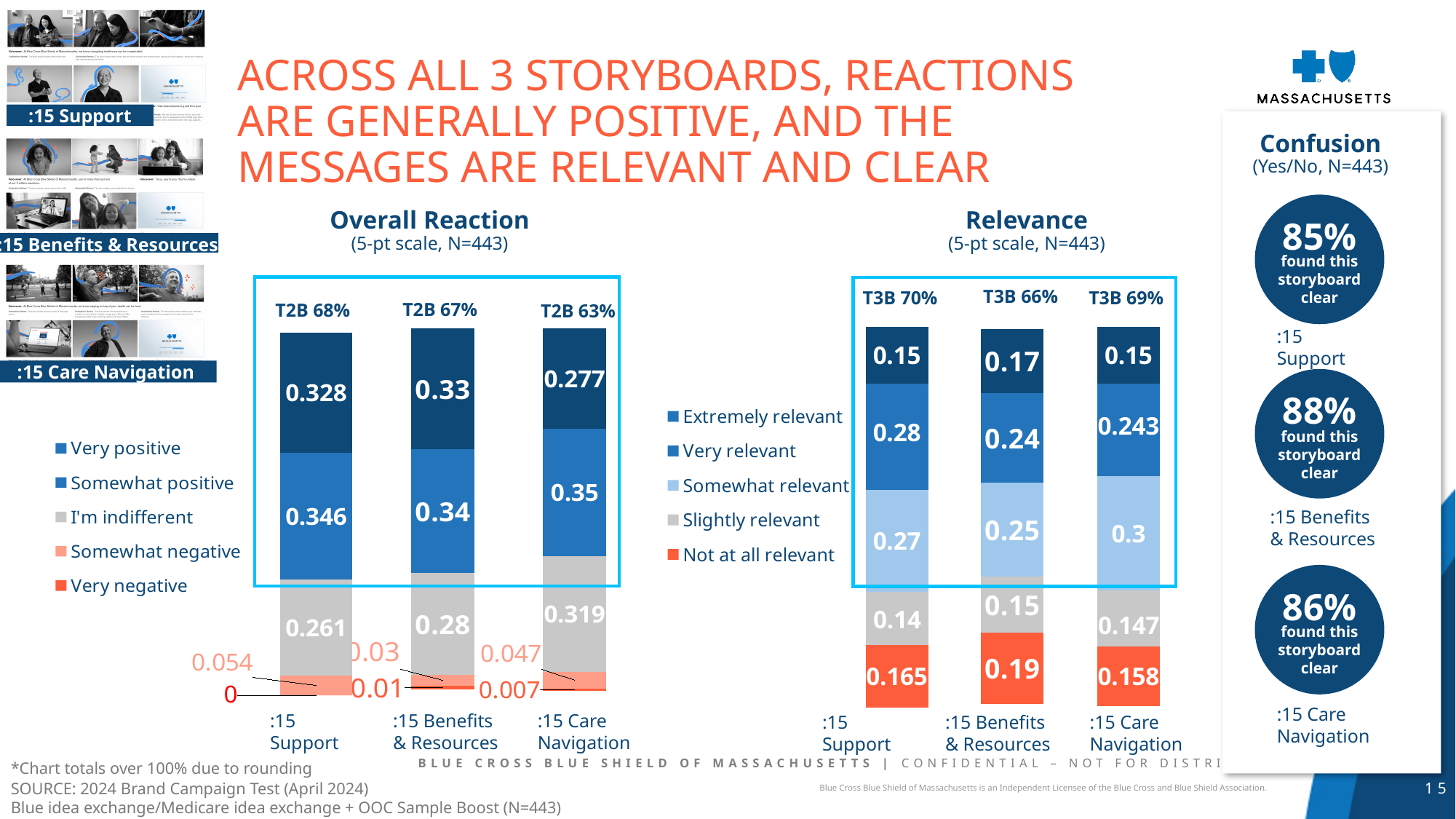
In the Overall Reaction chart, what is the Very positive value for :15 Support? 0.328 In the Overall Reaction chart, what is the I'm indifferent value for :15 Care Navigation? 0.319 In the Relevance chart, which storyboard has the highest Somewhat relevant value? :15 Care Navigation In the Overall Reaction chart, which storyboard has the lowest Very positive value? :15 Care Navigation How many series does the legend of the Relevance chart list? 5 In the Relevance chart, what is the Not at all relevant value for :15 Benefits & Resources? 0.19 In the Overall Reaction chart, which storyboard has the highest T2B percentage? :15 Support What type of chart is the Overall Reaction chart? Stacked bar chart In the Relevance chart, what is the T3B percentage for :15 Care Navigation? T3B 69% In the Overall Reaction chart, what is the difference between the Somewhat positive values for :15 Care Navigation and :15 Benefits & Resources? 0.01 How many storyboard categories are shown in the Overall Reaction chart? 3 In the Relevance chart, which is larger: the Very relevant value for :15 Support or for :15 Benefits & Resources? :15 Support